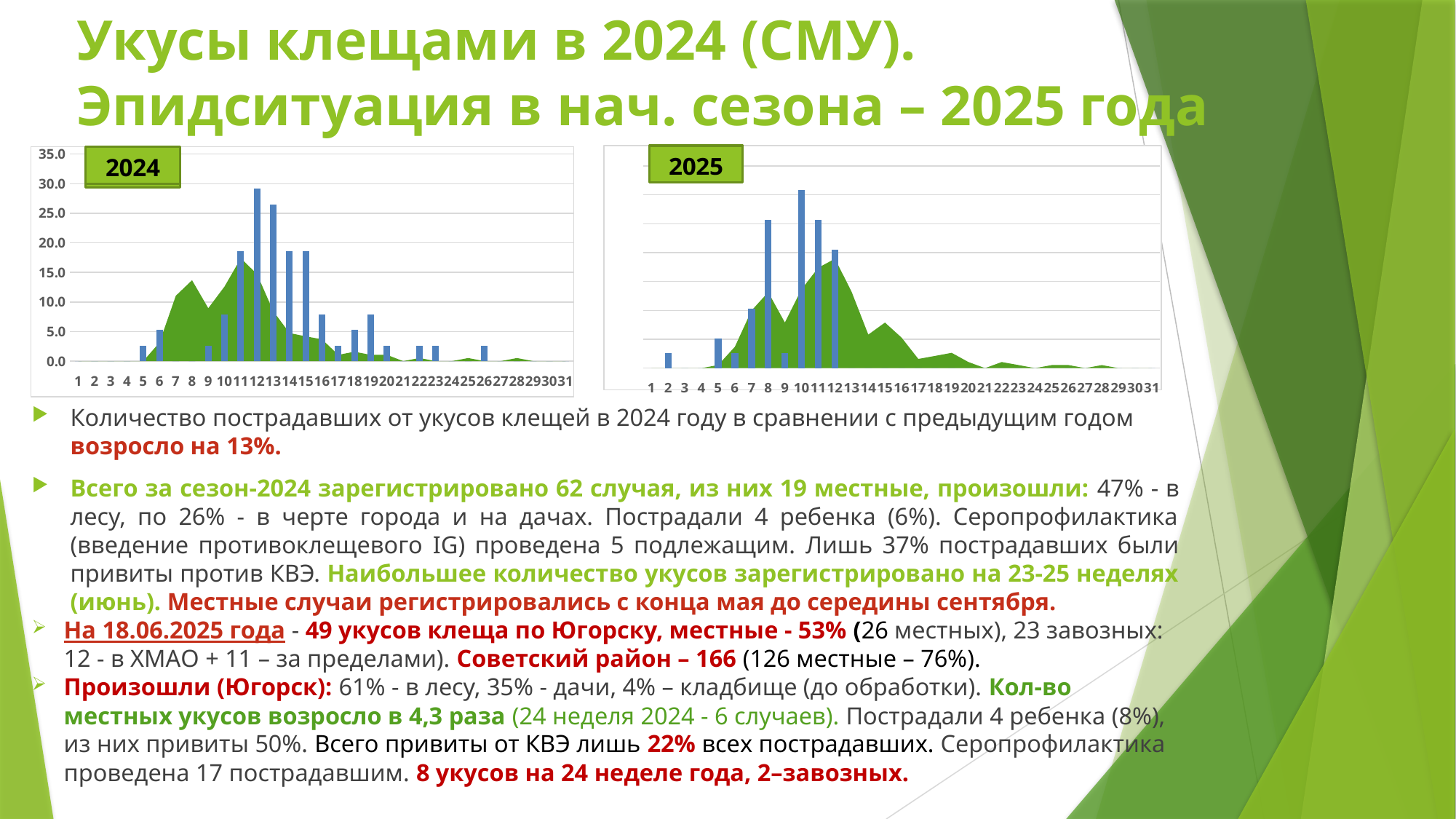
In the 2024 chart, which x-axis category has the tallest bar? 12 In the 2024 chart, is the bar for category 16 greater or less than 10.0? less In the 2024 chart, is the bar for category 12 greater or less than 25.0? greater What kind of chart is the left chart labelled 2024? bar chart (with an area series) In the 2025 chart, which bar is taller, category 10 or category 8? 10 In the 2024 chart, how many categories are shown on the x axis? 31 What year label is shown on the right chart? 2025 In the 2024 chart, is the bar for category 11 greater or less than 15.0? greater In the 2024 chart, do the bars rise or fall from category 12 to category 20? fall In the 2025 chart, which x-axis category has the tallest bar? 10 In the 2024 chart, which bar is taller, category 12 or category 14? 12